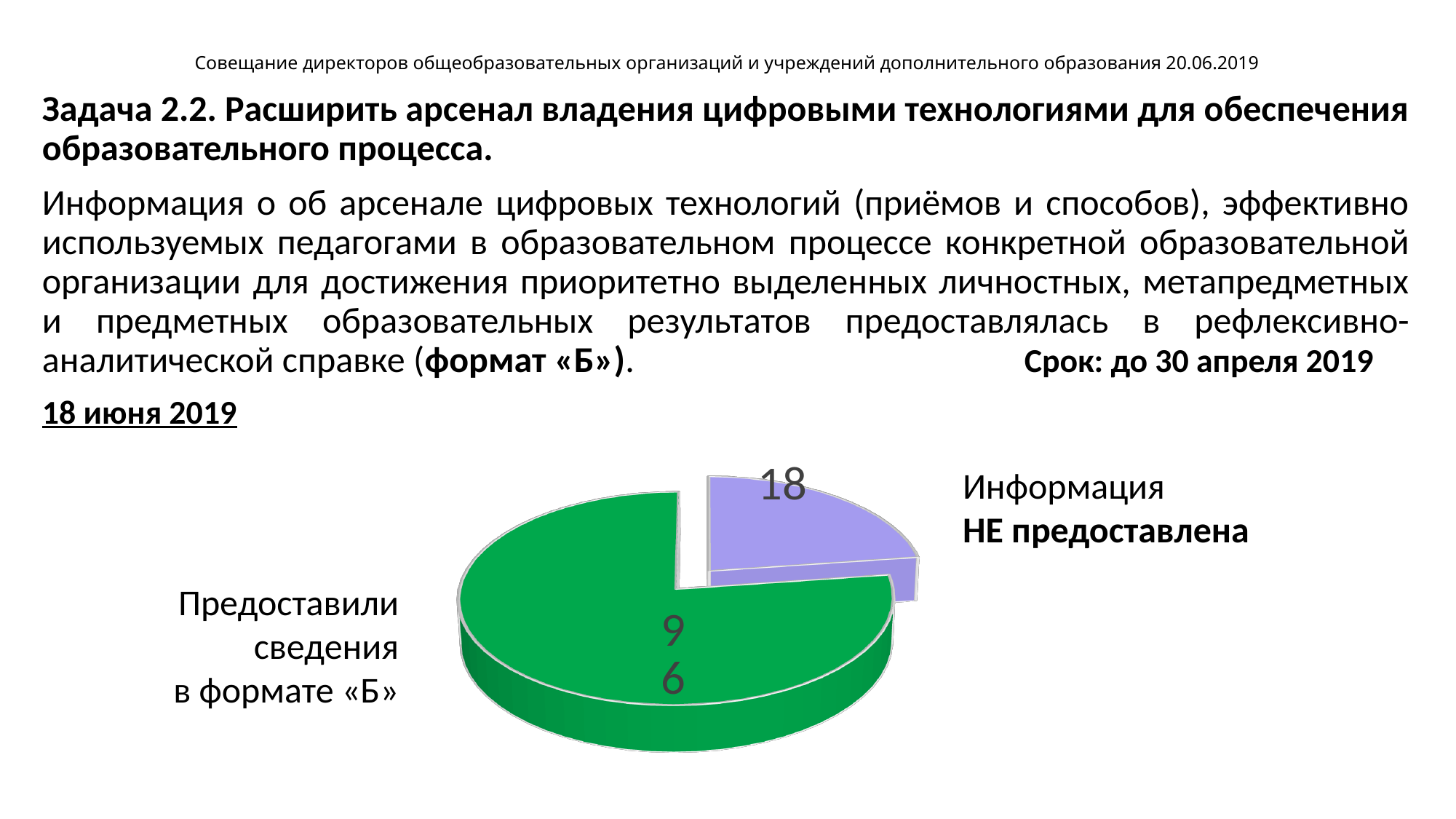
What value is shown for the slice 'Информация НЕ предоставлена'? 18 Which slice of the pie chart is the largest? Предоставили сведения в формате «Б» What colour is the slice labelled 'Предоставили сведения в формате «Б»'? green How many slices does the pie chart have? 2 What is the difference between the value for 'Предоставили сведения в формате «Б»' and the value for 'Информация НЕ предоставлена'? 78 What value is shown for the slice 'Предоставили сведения в формате «Б»'? 96 Which is larger: the number of organisations that provided information in format «Б» or the number that did not provide information? Предоставили сведения в формате «Б» What is the total of the two values shown in the pie chart? 114 Which slice of the pie chart is the smallest? Информация НЕ предоставлена What kind of chart is shown on the slide? pie chart What colour is the slice labelled 'Информация НЕ предоставлена'? purple